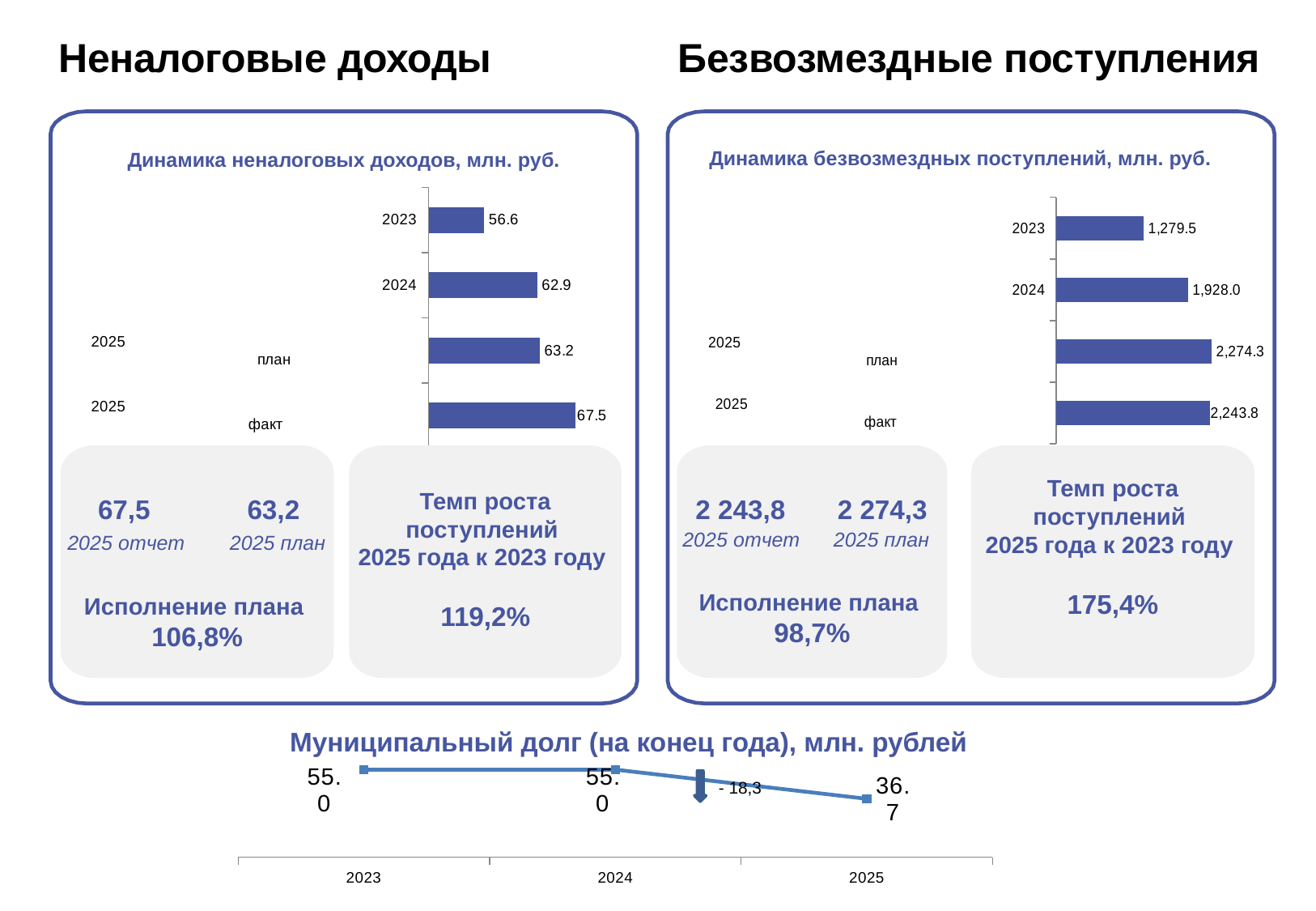
In the chart 'Динамика неналоговых доходов, млн. руб.', how many bars are plotted? 4 In the chart 'Динамика безвозмездных поступлений, млн. руб.', what is the value for 2024? 1,928.0 What type of chart is 'Муниципальный долг (на конец года), млн. рублей'? Line chart In the chart 'Муниципальный долг (на конец года), млн. рублей', what is the value for 2025? 36.7 In the chart 'Динамика неналоговых доходов, млн. руб.', what is the value for 2025 факт? 67.5 In the chart 'Динамика безвозмездных поступлений, млн. руб.', which is larger: the 2025 план value or the 2025 факт value? 2025 план In the chart 'Динамика неналоговых доходов, млн. руб.', what is the difference between the 2025 факт and 2025 план values? 4.3 In the chart 'Динамика неналоговых доходов, млн. руб.', which category has the highest value? 2025 факт In the chart 'Муниципальный долг (на конец года), млн. рублей', do the values rise or fall from 2024 to 2025? Fall In the chart 'Динамика безвозмездных поступлений, млн. руб.', what is the difference between the 2024 and 2023 values? 648.5 In the chart 'Динамика безвозмездных поступлений, млн. руб.', which category has the lowest value? 2023 In the chart 'Динамика неналоговых доходов, млн. руб.', what is the value for 2023? 56.6